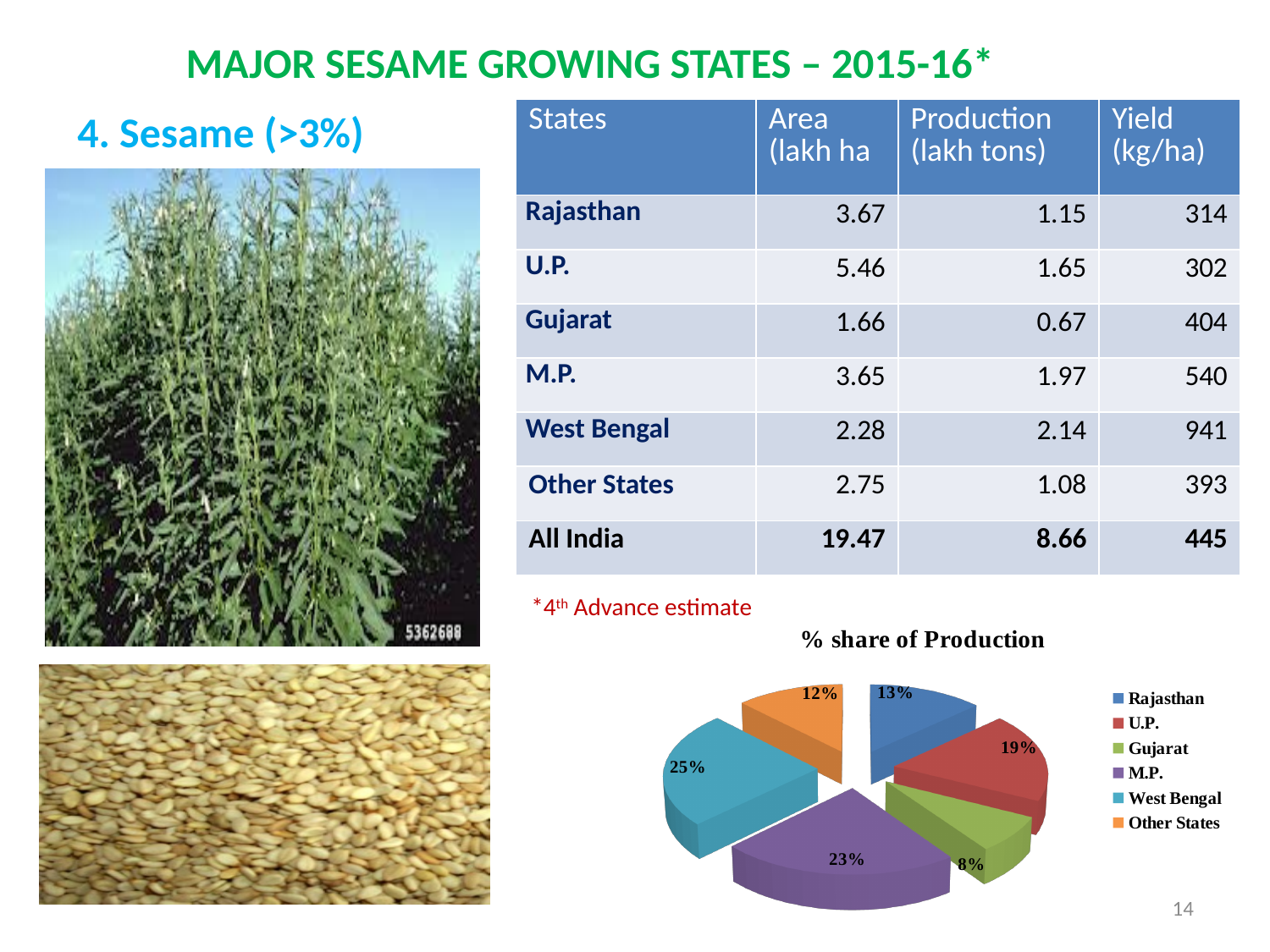
In the '% share of Production' pie chart, which has a larger share, U.P. or Other States? U.P. In the '% share of Production' pie chart, which state has the largest share? West Bengal In the '% share of Production' pie chart, what is the share for M.P.? 23% How many slices does the '% share of Production' pie chart have? 6 In the '% share of Production' pie chart, what is the share for Gujarat? 8% In the '% share of Production' pie chart, which state has the smallest share? Gujarat What kind of chart is shown under the title '% share of Production'? pie chart In the '% share of Production' pie chart, what is the share for Rajasthan? 13% In the '% share of Production' pie chart, what is the difference between the shares of West Bengal and Rajasthan? 12% In the '% share of Production' pie chart, what is the share for West Bengal? 25% How many entries does the legend of the '% share of Production' pie chart list? 6 In the '% share of Production' pie chart, what is the share for U.P.? 19%